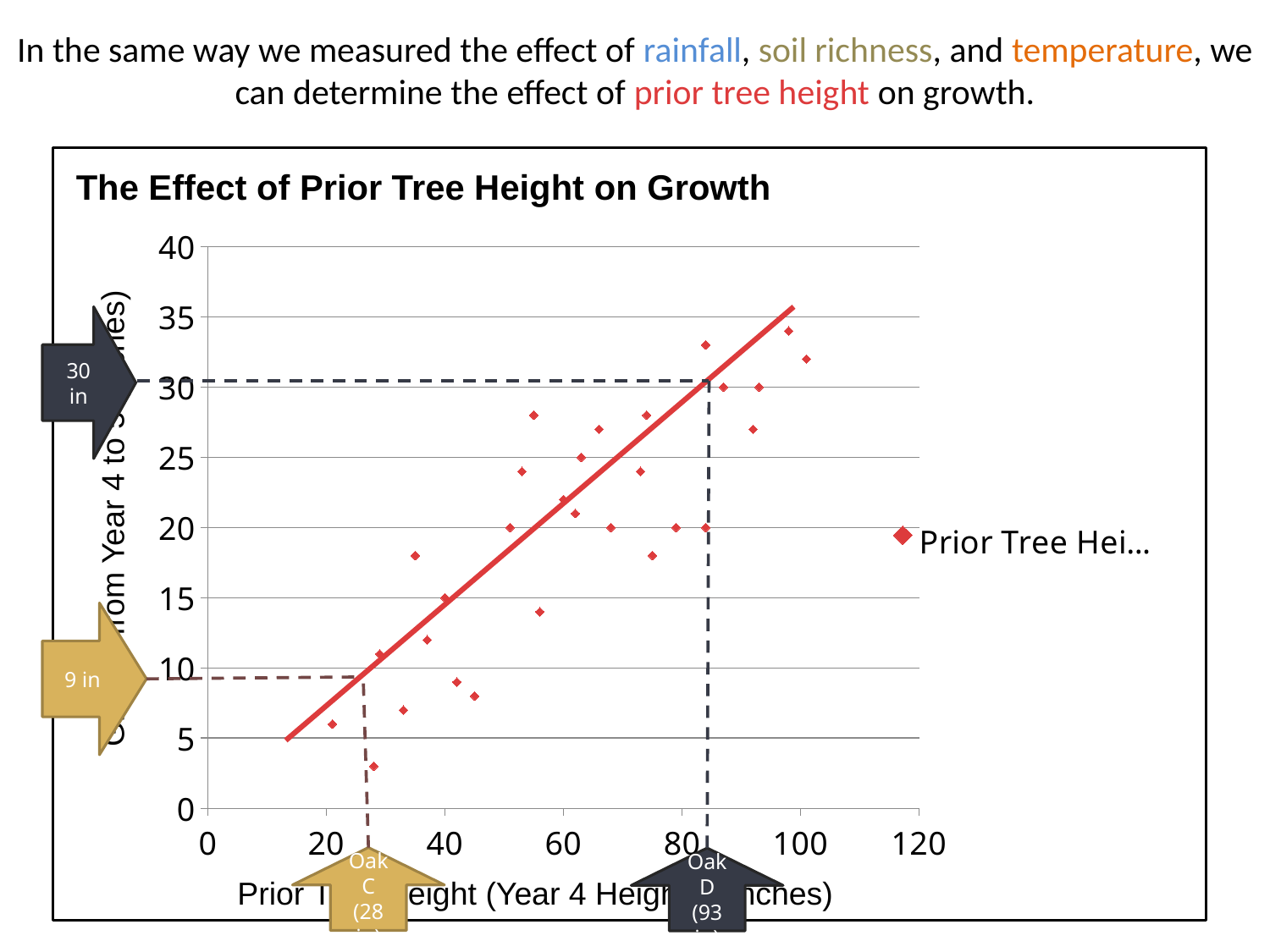
Do the plotted growth values generally rise or fall as prior tree height increases along the x axis? rise What is the difference between the annotated growth values for Oak D and Oak C? 21 in What kind of chart is shown on the slide? scatter chart How many series does the chart's legend list? 1 Is the growth value of the lowest plotted point greater or less than 5? less Which annotated tree has the larger predicted growth, Oak C or Oak D? Oak D What is the title of the chart? The Effect of Prior Tree Height on Growth What is the highest value shown on the y axis? 40 Is the growth value of the highest plotted point greater or less than 30? greater According to the annotation, what growth does the trend line give for Oak C (28 in)? 9 in What is the highest tick value shown on the x axis? 120 According to the annotation, what growth does the trend line give for Oak D (93 in)? 30 in